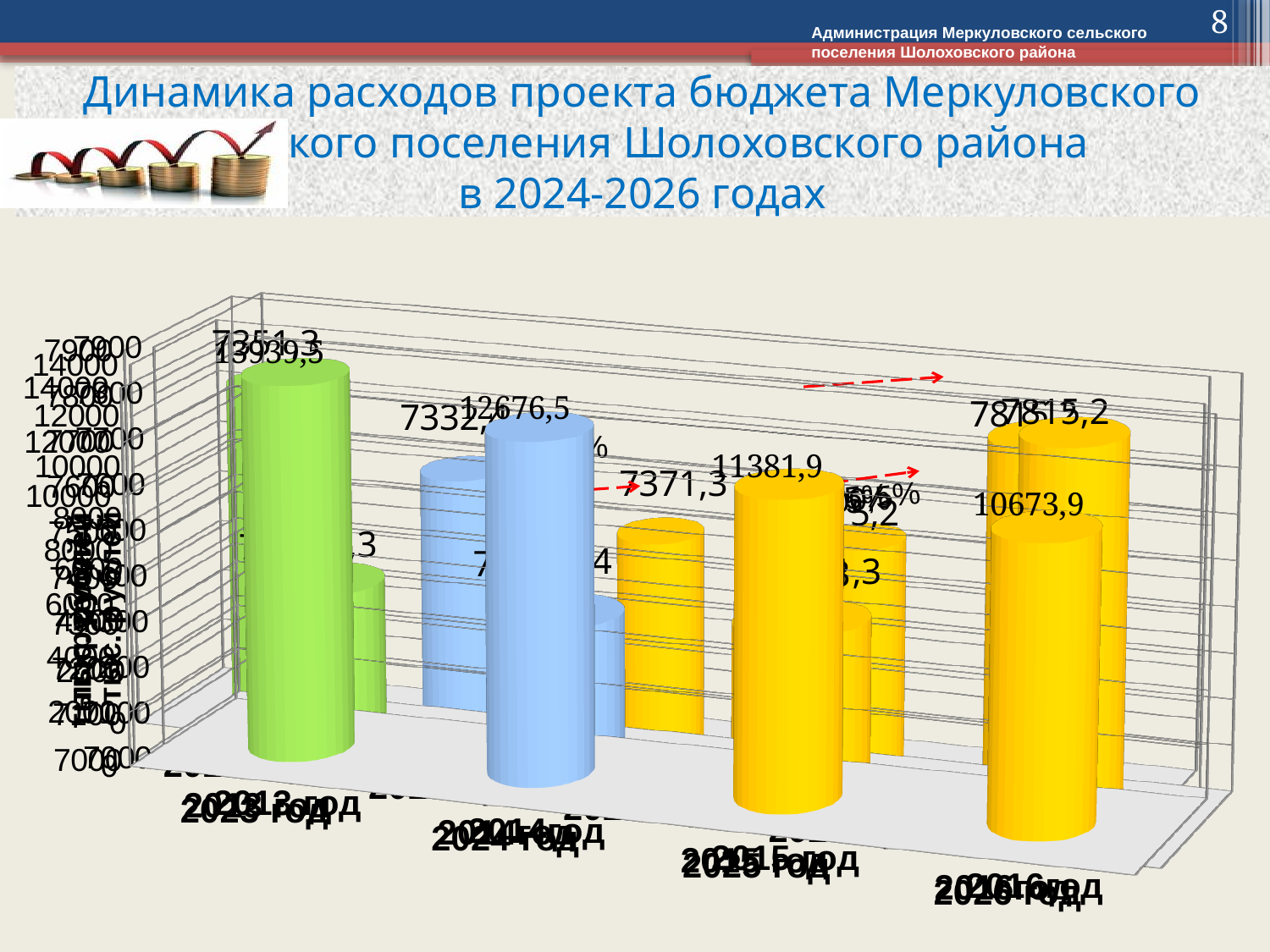
What kind of chart is shown on the slide? bar chart In the front chart with the large cylinders, what is the value labelled for 2024 год? 12676,5 In the front chart with the large cylinders, what is the value labelled for 2023 год? 13939,5 In the front chart with the large cylinders, what is the value labelled for 2026 год? 10673,9 In the front chart with the large cylinders, which year has the highest value? 2023 год In the front chart with the large cylinders, do the values rise or fall from 2023 год to 2026 год? fall In the front chart with the large cylinders, what is the difference between the values for 2023 год and 2026 год? 3265,6 In the front chart with the large cylinders, what is the difference between the values for 2024 год and 2025 год? 1294,6 In the front chart with the large cylinders, which is larger: the value for 2024 год or the value for 2025 год? 2024 год In the front chart with the large cylinders, how many year categories are shown along the x axis? 4 In the front chart with the large cylinders, what is the value labelled for 2025 год? 11381,9 In the front chart with the large cylinders, which year has the lowest value? 2026 год